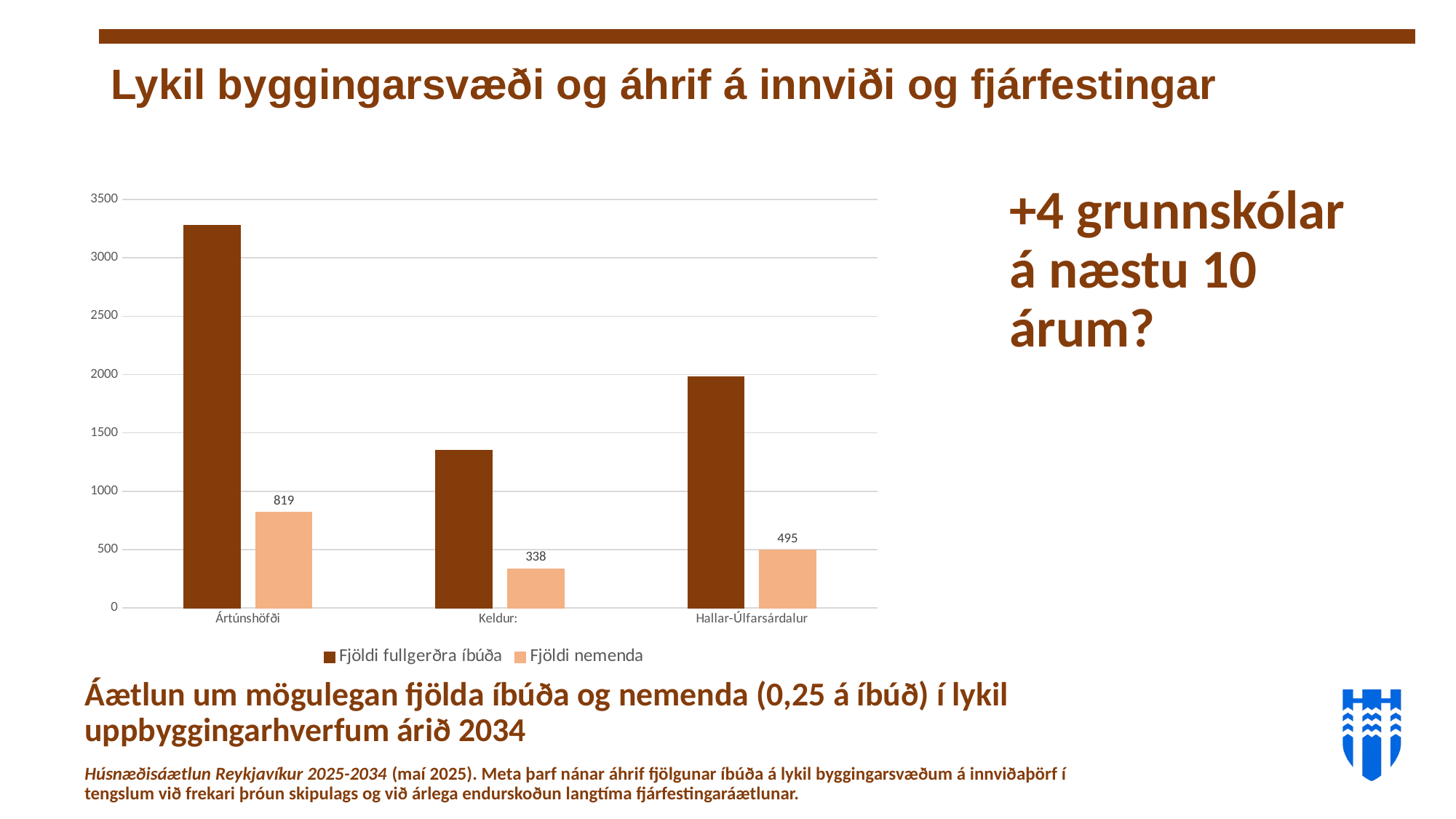
Which category has the highest Fjöldi fullgerðra íbúða value? Ártúnshöfði Which category has the highest Fjöldi nemenda value? Ártúnshöfði Is the Fjöldi fullgerðra íbúða value for Ártúnshöfði greater or less than 3000? greater Is the Fjöldi fullgerðra íbúða value for Keldur greater or less than 1500? less What kind of chart is shown on the slide? Bar chart What is the difference between the Fjöldi nemenda values for Ártúnshöfði and Keldur? 481 How many series does the legend list? 2 Which category has the lowest Fjöldi nemenda value? Keldur What is the value of Fjöldi nemenda for Keldur? 338 What is the value of Fjöldi nemenda for Ártúnshöfði? 819 What is the value of Fjöldi nemenda for Hallar-Úlfarsárdalur? 495